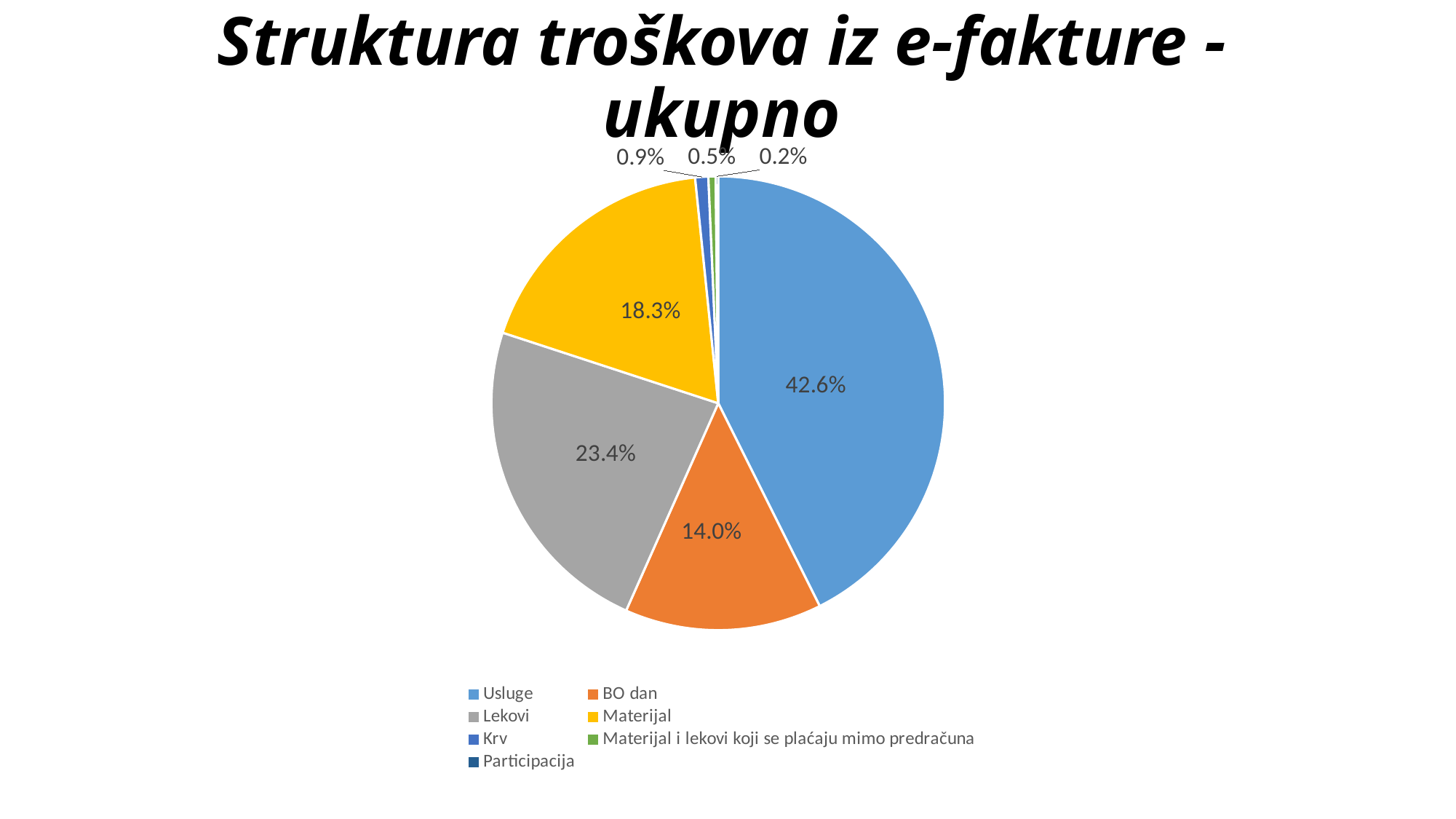
What is the title of the chart? Struktura troškova iz e-fakture - ukupno What share of the pie does BO dan have? 14.0% What is the difference between the Lekovi share and the BO dan share? 9.4% What share of the pie does Usluge have? 42.6% What colour is the Materijal slice? yellow What is the difference between the Usluge share and the Lekovi share? 19.2% What share of the pie does Lekovi have? 23.4% Which category has the largest slice of the pie? Usluge What kind of chart is shown on the slide? pie chart What share of the pie does Materijal have? 18.3% How many categories does the legend list? 7 Which slice is larger, Lekovi or Materijal? Lekovi